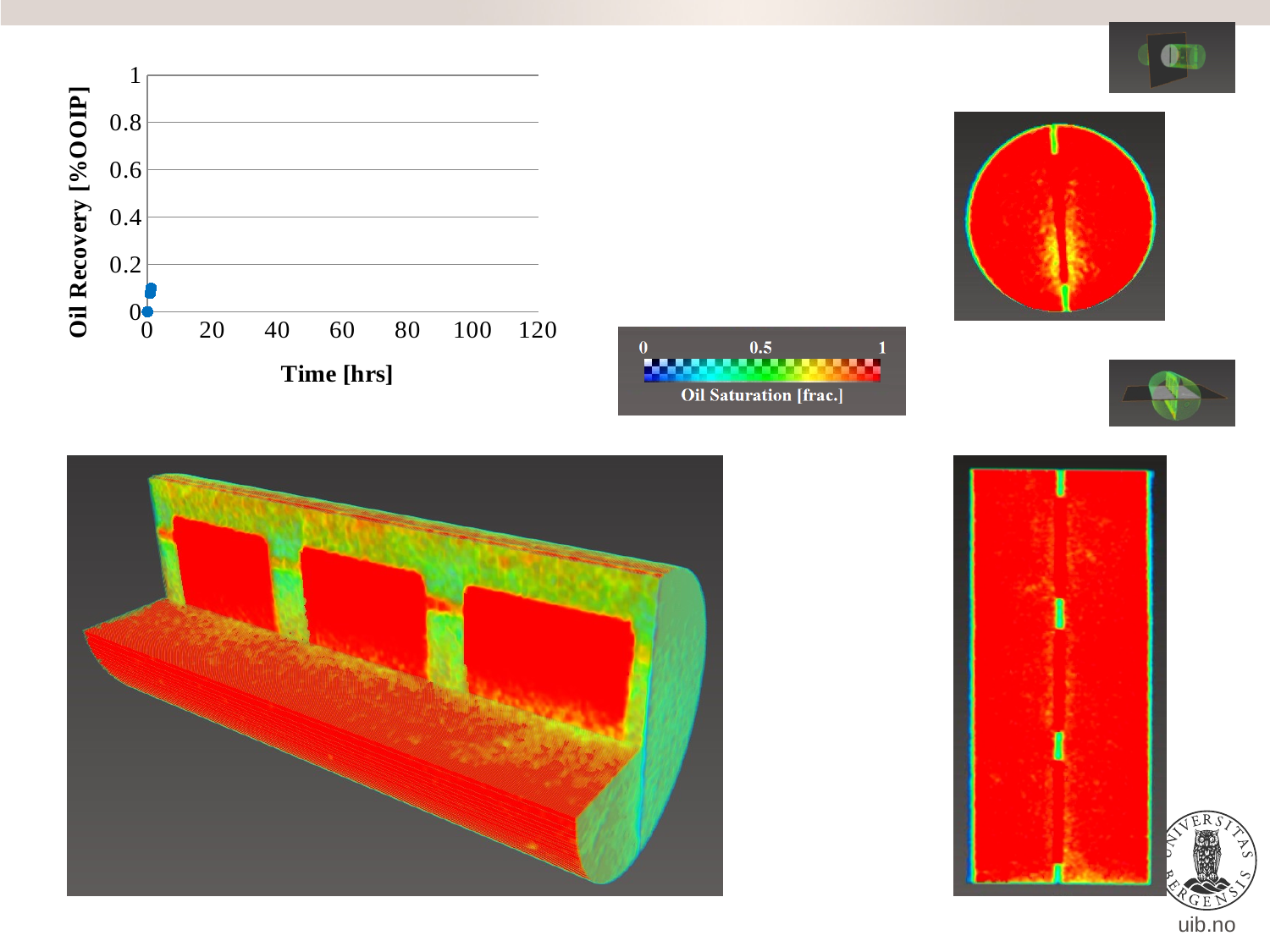
What is the title of the x axis of the chart? Time [hrs] Are the plotted oil recovery values greater or less than 0.2? less Are the plotted points located at a time greater or less than 20 hrs? less What is the title of the y axis of the chart? Oil Recovery [%OOIP] What is the highest value shown on the y axis of the chart? 1 What kind of chart is shown in the top-left of the slide? scatter chart